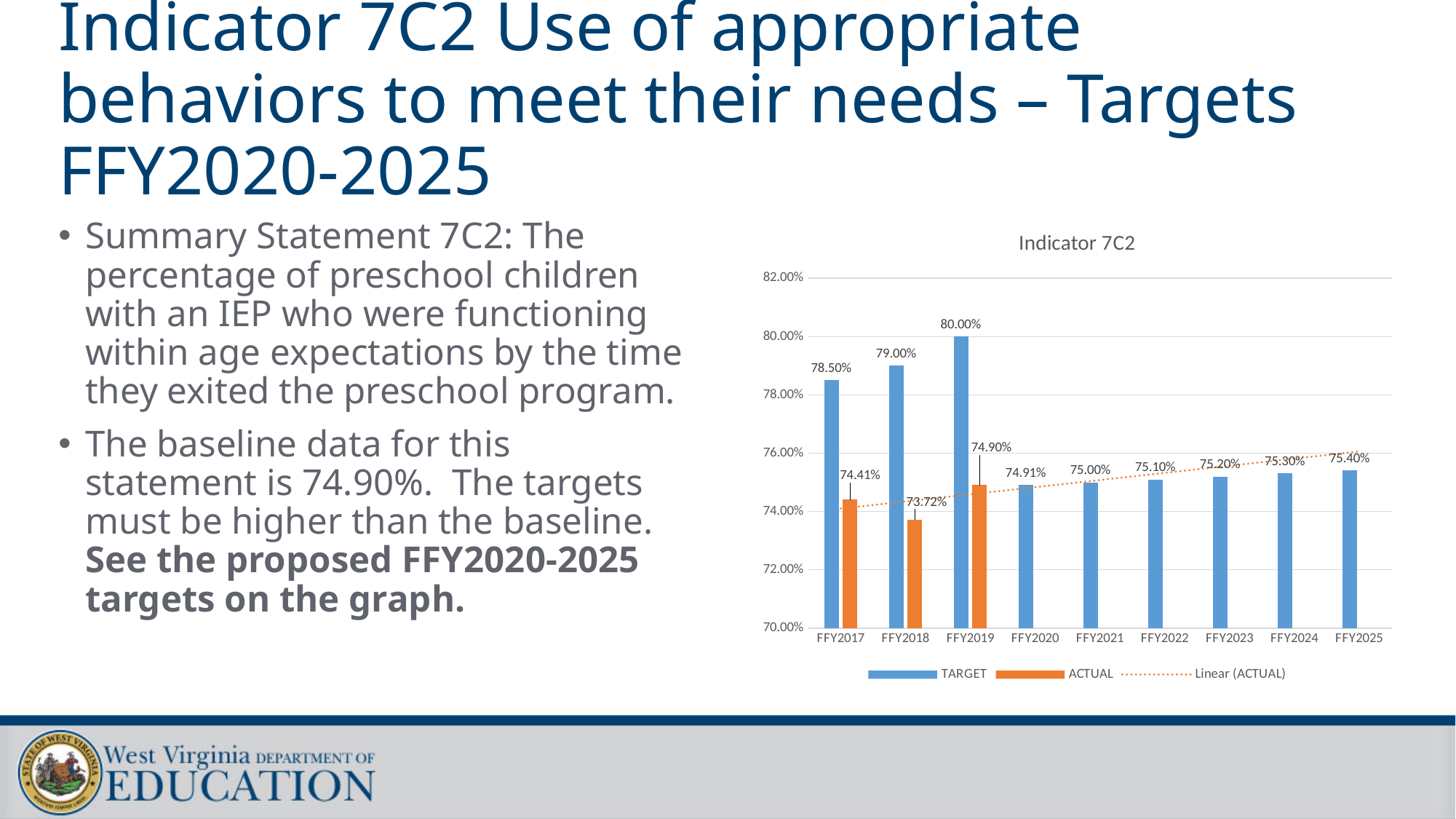
How many years are shown on the x axis? 9 Is the TARGET value for FFY2018 greater or less than 78.00%? greater Which year has the highest TARGET value? FFY2019 How many entries does the legend list? 3 What is the difference between the TARGET and ACTUAL values for FFY2019? 5.10% What kind of chart is shown on the slide? bar chart Do the TARGET values rise or fall from FFY2020 to FFY2025? rise Which is larger, the ACTUAL value for FFY2017 or the ACTUAL value for FFY2018? FFY2017 What is the TARGET value for FFY2019? 80.00% What is the ACTUAL value for FFY2018? 73.72% What is the TARGET value for FFY2025? 75.40% Which year has the lowest ACTUAL value? FFY2018